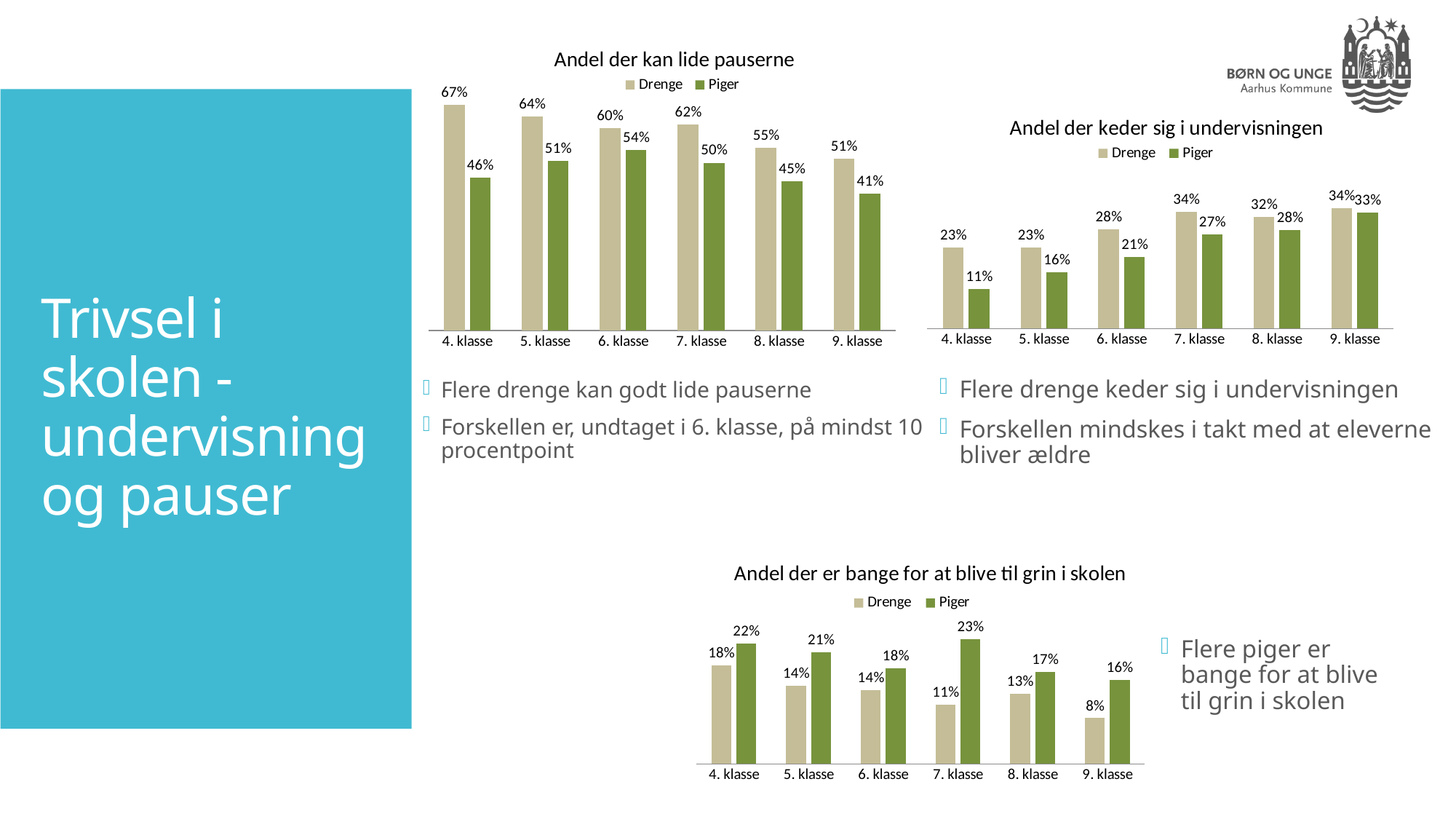
In the chart 'Andel der er bange for at blive til grin i skolen', what is the value for Drenge in 9. klasse? 8% In the chart 'Andel der er bange for at blive til grin i skolen', which klasse has the highest value for Piger? 7. klasse How many series does the legend of the chart 'Andel der er bange for at blive til grin i skolen' list? 2 In the chart 'Andel der keder sig i undervisningen', which klasse has the lowest value for Piger? 4. klasse In the chart 'Andel der keder sig i undervisningen', what is the difference between Drenge and Piger in 9. klasse? 1 percentage point What kind of chart is 'Andel der keder sig i undervisningen'? Bar chart In the chart 'Andel der keder sig i undervisningen', what is the value for Piger in 4. klasse? 11% In the chart 'Andel der er bange for at blive til grin i skolen', which is larger in 7. klasse, Drenge or Piger? Piger In the chart 'Andel der kan lide pauserne', which klasse has the highest value for Piger? 6. klasse In the chart 'Andel der kan lide pauserne', what is the value for Drenge in 4. klasse? 67% In the chart 'Andel der kan lide pauserne', what is the value for Piger in 9. klasse? 41% In the chart 'Andel der kan lide pauserne', what is the difference between Drenge and Piger in 4. klasse? 21 percentage points